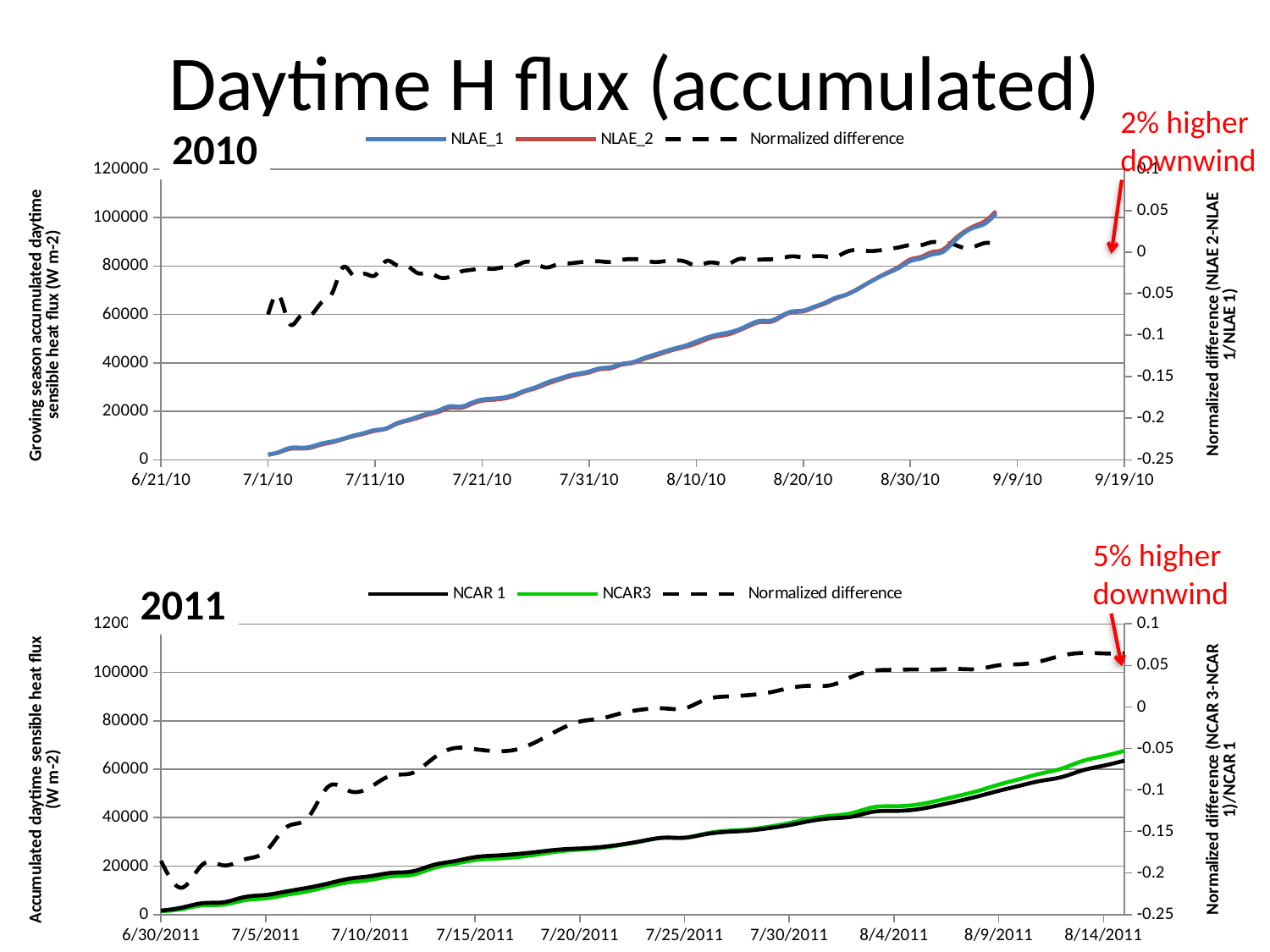
In the 2010 chart, does the NLAE_1 accumulated flux rise or fall over the growing season? rise In the 2011 chart, does the Normalized difference line rise or fall from 6/30/2011 to 8/14/2011? rise How many series does the legend of the 2011 chart list? 3 What colour is the NCAR3 line in the 2011 chart? green What kind of chart is the 2010 chart at the top of the slide? line chart According to the annotation on the 2011 chart, how much higher is the flux downwind? 5% higher downwind In the 2010 chart, is the NLAE_2 value on 7/31/10 greater or less than 40000? less In the 2011 chart, is the NCAR 1 value on 7/20/2011 greater or less than 40000? less In the 2011 chart, is the NCAR3 value on 8/14/2011 greater or less than 60000? greater How many series does the legend of the 2010 chart list? 3